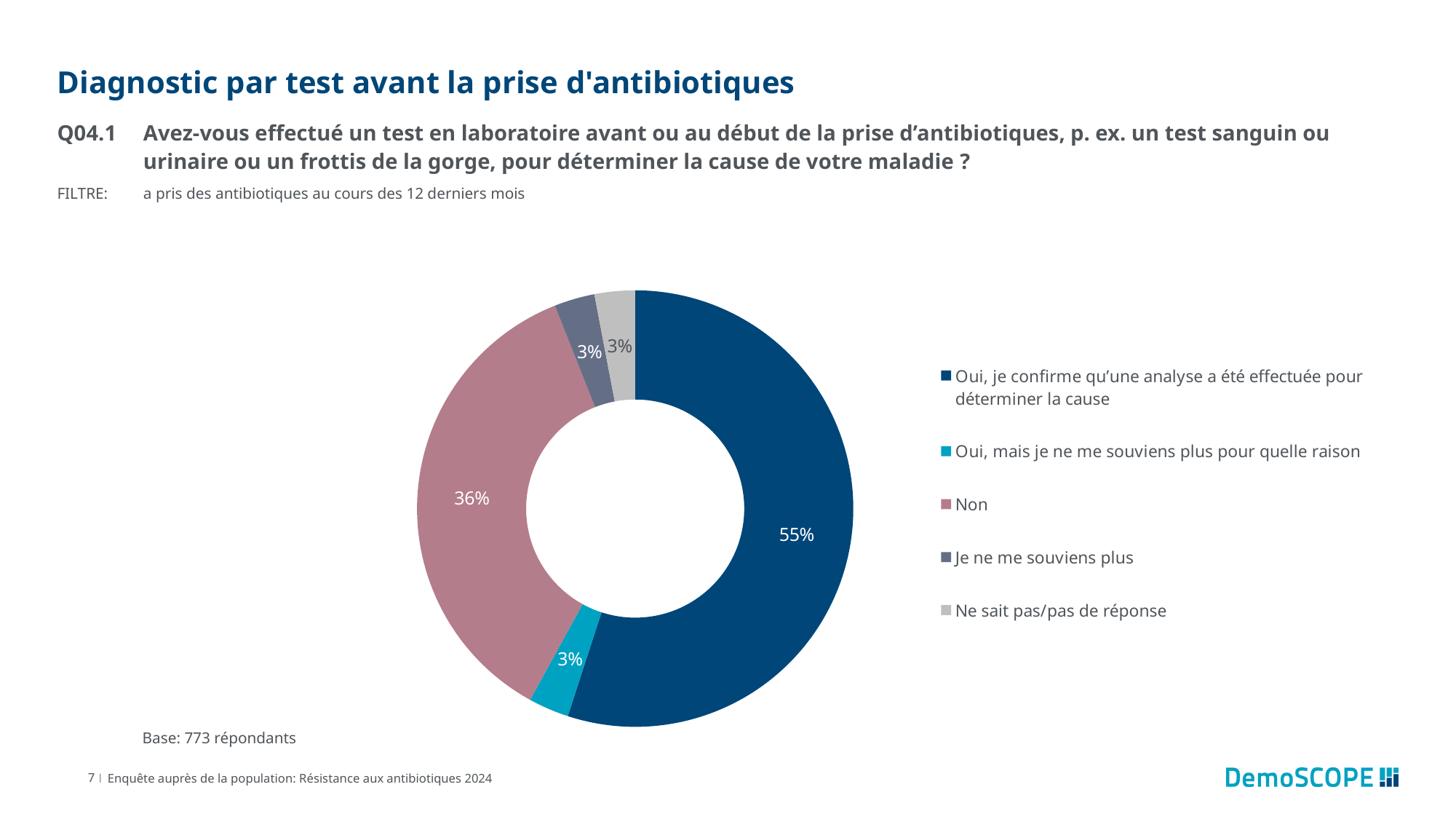
What share of respondents answered "Non"? 36% What share of respondents answered "Ne sait pas/pas de réponse"? 3% How many respondents form the base of the chart? 773 répondants How many response categories does the legend list? 5 What is the combined share of the two "Oui" responses? 58% What is the difference in percentage points between the "Oui, je confirme..." share and the "Non" share? 19 percentage points Which response category has the largest share of the chart? Oui, je confirme qu'une analyse a été effectuée pour déterminer la cause What share of respondents answered "Oui, je confirme qu'une analyse a été effectuée pour déterminer la cause"? 55% What share of respondents answered "Oui, mais je ne me souviens plus pour quelle raison"? 3% What kind of chart is shown on the slide? Pie chart (donut) Which is larger: the share for "Non" or the share for "Oui, je confirme qu'une analyse a été effectuée pour déterminer la cause"? Oui, je confirme qu'une analyse a été effectuée pour déterminer la cause What share of respondents answered "Je ne me souviens plus"? 3%